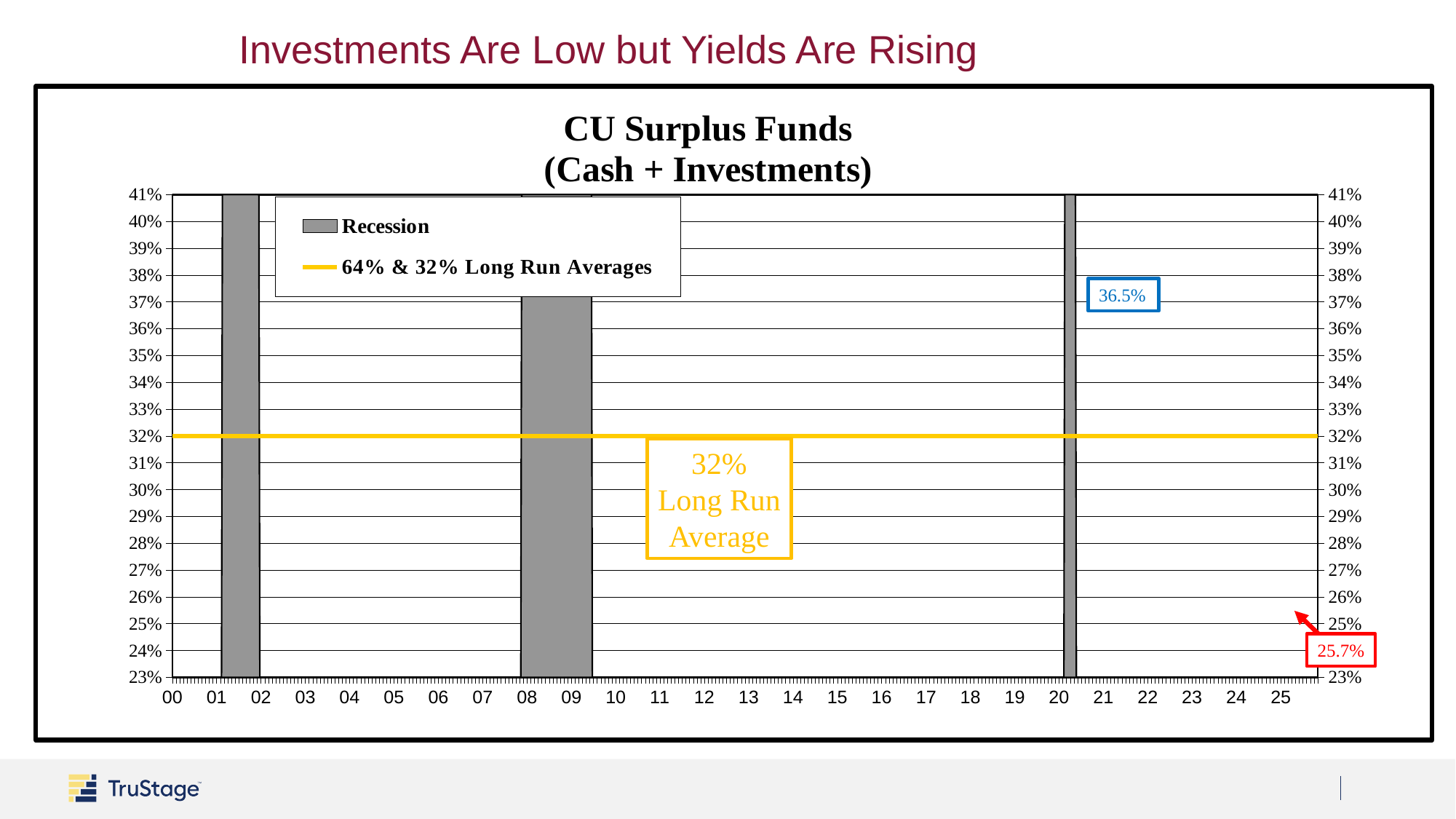
At what level is the yellow long run average line drawn? 32% Which labeled value is larger, 36.5% near 2021 or 25.7% near 2025? 36.5% What does the yellow horizontal line on the chart represent? 32% Long Run Average What is the difference between the labeled values 36.5% and 25.7%? 10.8 percentage points What value is shown in the red label at the right end of the chart near 2025? 25.7% What is the title of the chart? CU Surplus Funds (Cash + Investments) Is the labeled value 36.5% greater or less than the 32% long run average? greater How many shaded recession periods are shown on the chart? 3 Is the labeled value 25.7% greater or less than the 32% long run average? less What value is shown in the blue label near 2021? 36.5% How many entries does the chart legend list? 2 What is the range of the vertical axis on the chart? 23% to 41%